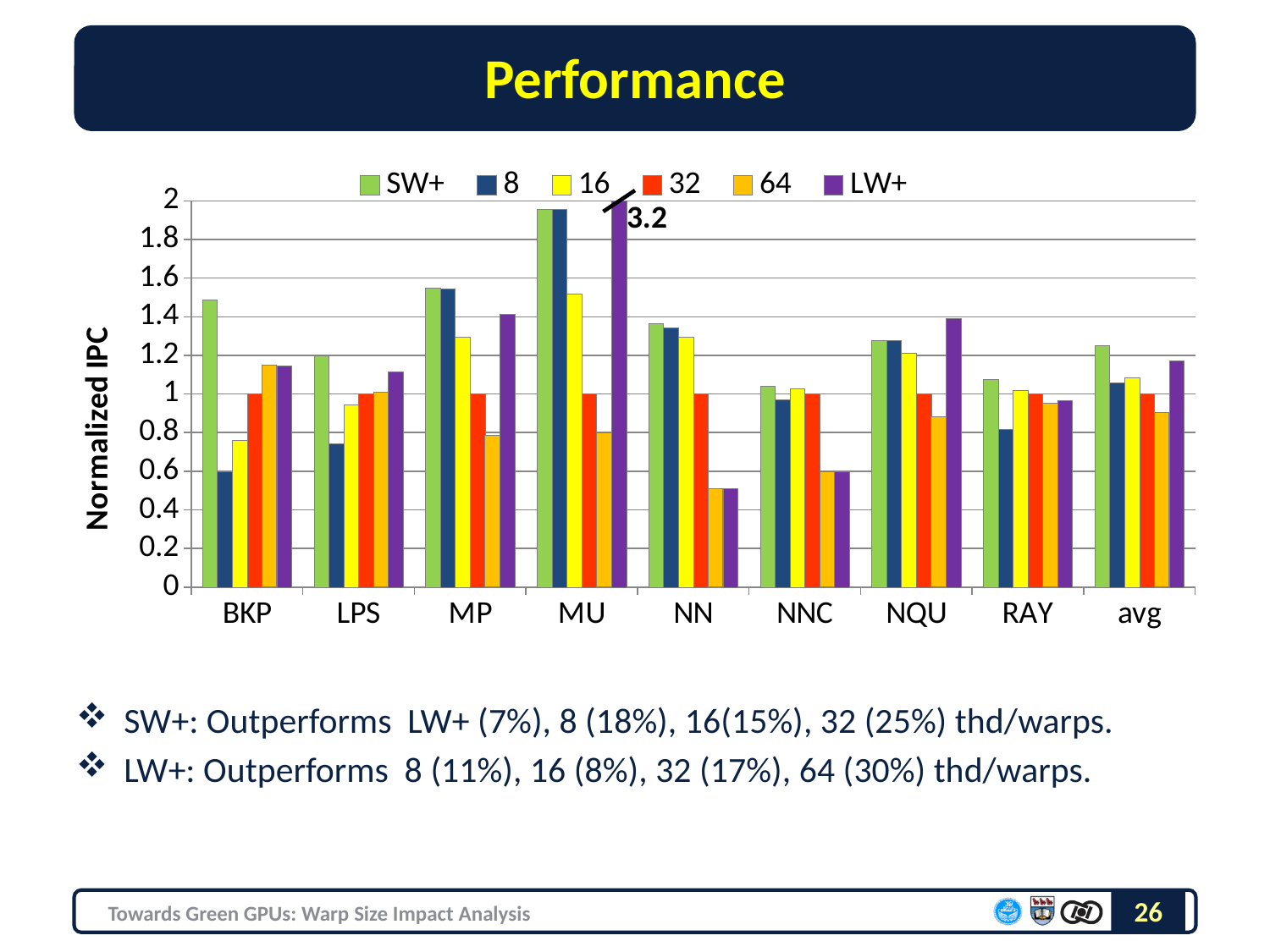
How many categories are shown along the x axis? 9 What is the value of LW+ for MU? 3.2 Which series has the highest value for MU? LW+ Which category has the lowest value for the 8 series? BKP For RAY, which is larger: SW+ or 8? SW+ Is the value of the 8 series for BKP greater or less than 0.8? less Which category has the highest LW+ value? MU What type of chart is shown on the slide? bar chart What is the label of the y axis? Normalized IPC Is the value of LW+ for NQU greater or less than 1.2? greater Is the value of SW+ for BKP greater or less than 1.2? greater How many series does the legend list? 6